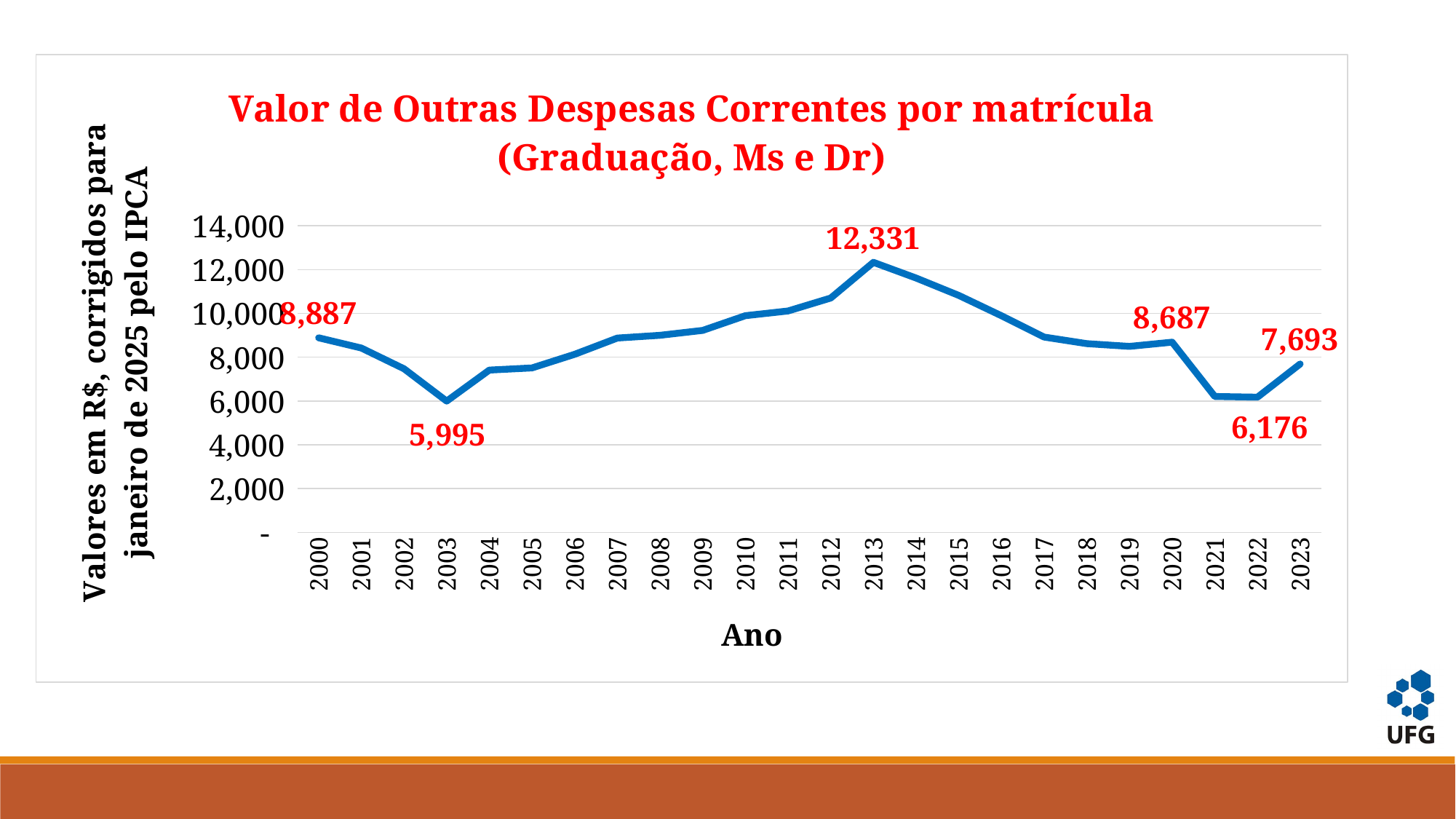
What type of chart is shown on the slide? line chart What is the value for the year 2003? 5,995 What is the value for the year 2020? 8,687 Which is larger, the value for 2000 or the value for 2020? 2000 Is the value for 2021 greater or less than 8,000? less Which year has the lowest value? 2003 How many years are shown on the x axis? 24 What is the value for the year 2000? 8,887 What is the difference between the values for 2013 and 2003? 6,336 What is the value for the year 2013? 12,331 What is the value for the year 2023? 7,693 Which year has the highest value? 2013